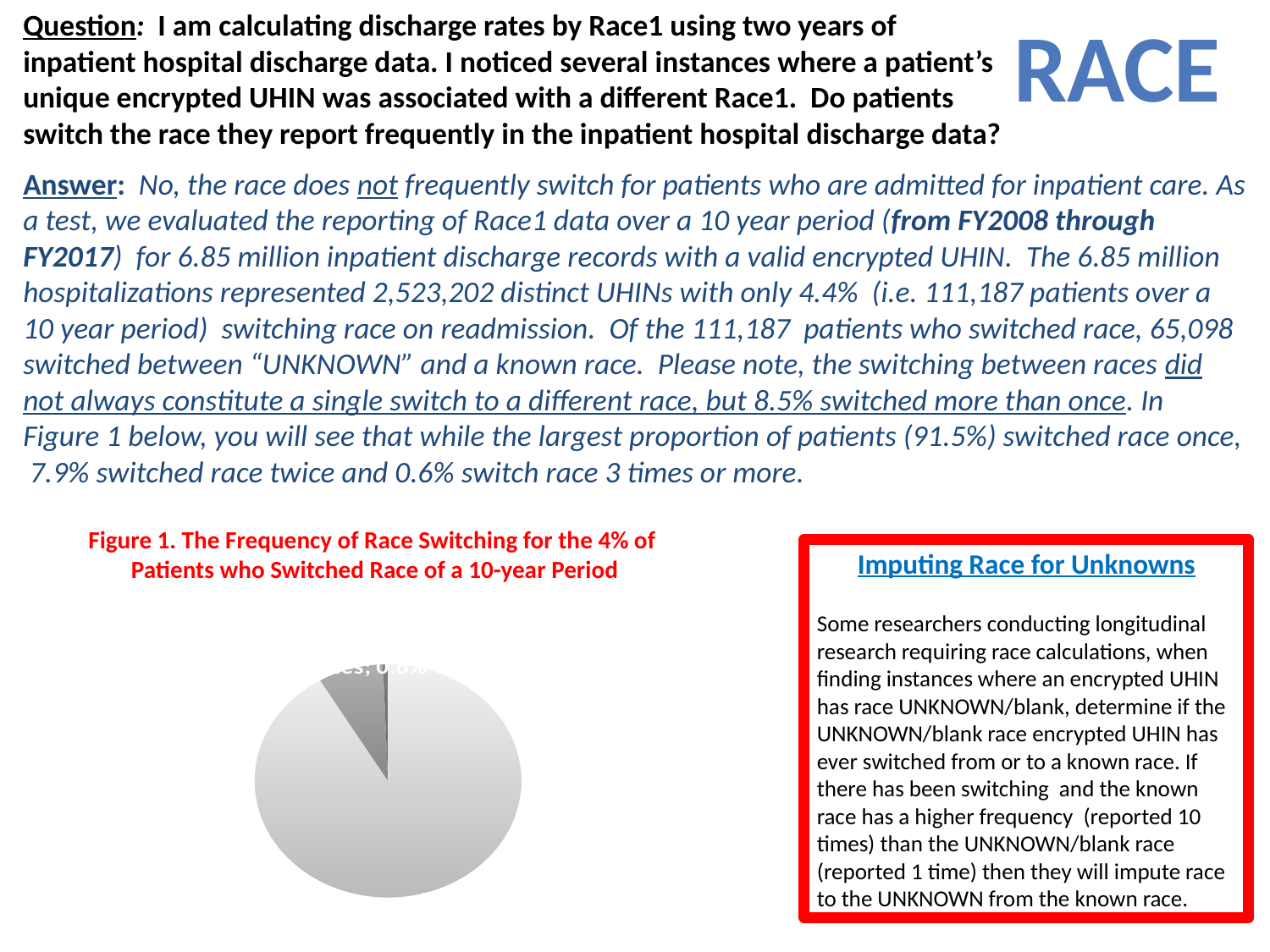
In the pie chart, which colour slice takes up the largest share of the pie? Light grey What is the title of the chart on the slide? Figure 1. The Frequency of Race Switching for the 4% of Patients who Switched Race of a 10-year Period In the pie chart, is the dark grey slice larger or smaller than the light grey slice? Smaller Does the light grey slice of the pie chart cover more or less than half of the pie? More What kind of chart is shown in Figure 1 on the slide? Pie chart